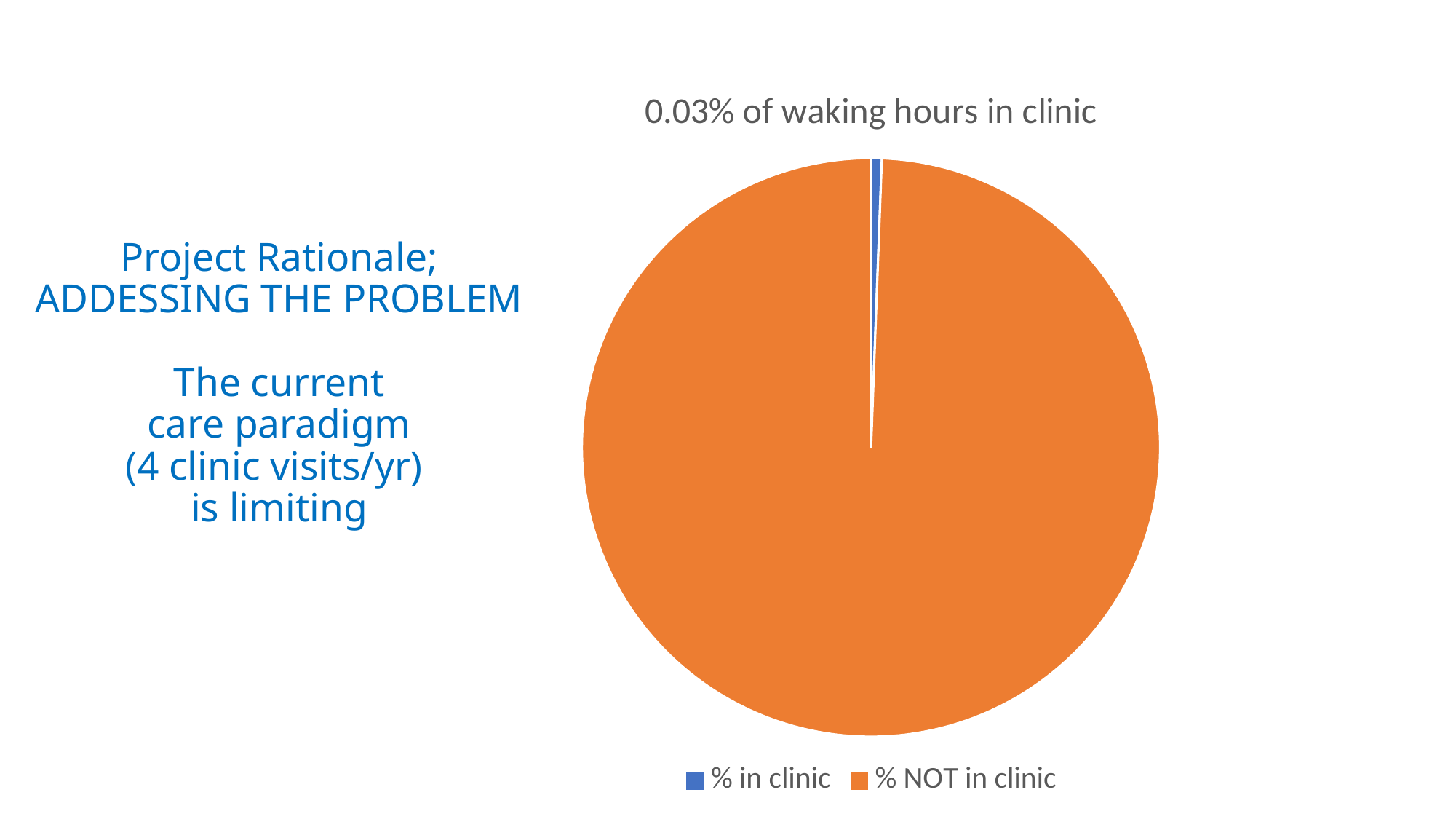
What colour represents % NOT in clinic in the pie chart? orange What is the title of the pie chart? 0.03% of waking hours in clinic Which slice of the pie chart is the largest? % NOT in clinic How many entries does the legend of the pie chart list? 2 Which slice of the pie chart is the smallest? % in clinic What kind of chart is shown on the slide? pie chart How many slices does the pie chart have? 2 Which is larger in the pie chart, % in clinic or % NOT in clinic? % NOT in clinic According to the chart title, what percentage of waking hours is spent in clinic? 0.03%